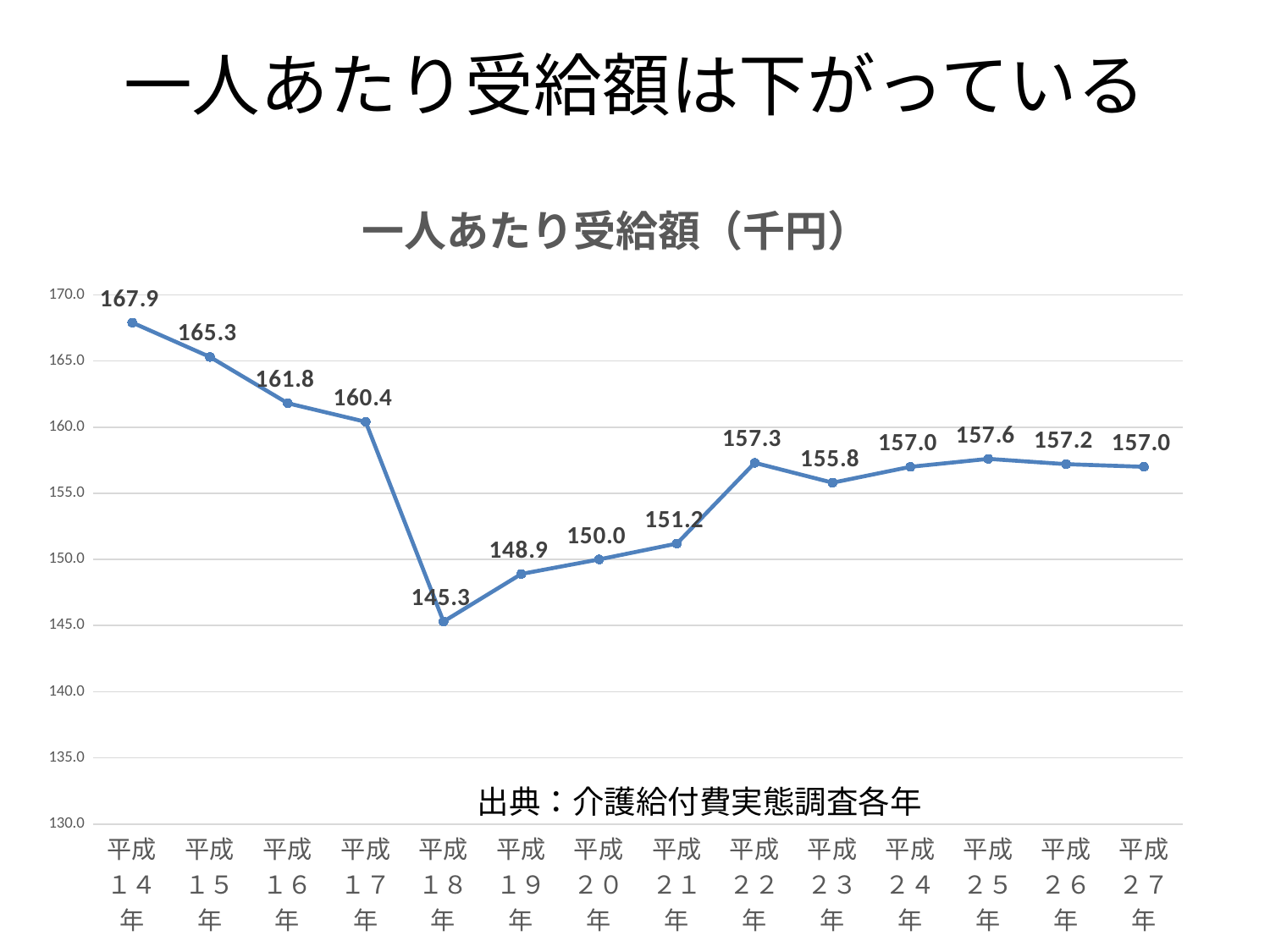
How many years are plotted on the chart? 14 Which year has the highest value? 平成14年 What is the difference between the values for 平成14年 and 平成27年? 10.9 Is the value for 平成19年 greater or less than 150.0? less What is the value for 平成14年? 167.9 What kind of chart is shown on the slide? line chart What is the value for 平成18年? 145.3 What is the title of the chart? 一人あたり受給額（千円） Which is larger, the value for 平成22年 or the value for 平成23年? 平成22年 What is the difference between the values for 平成17年 and 平成18年? 15.1 What is the value for 平成25年? 157.6 Which year has the lowest value? 平成18年